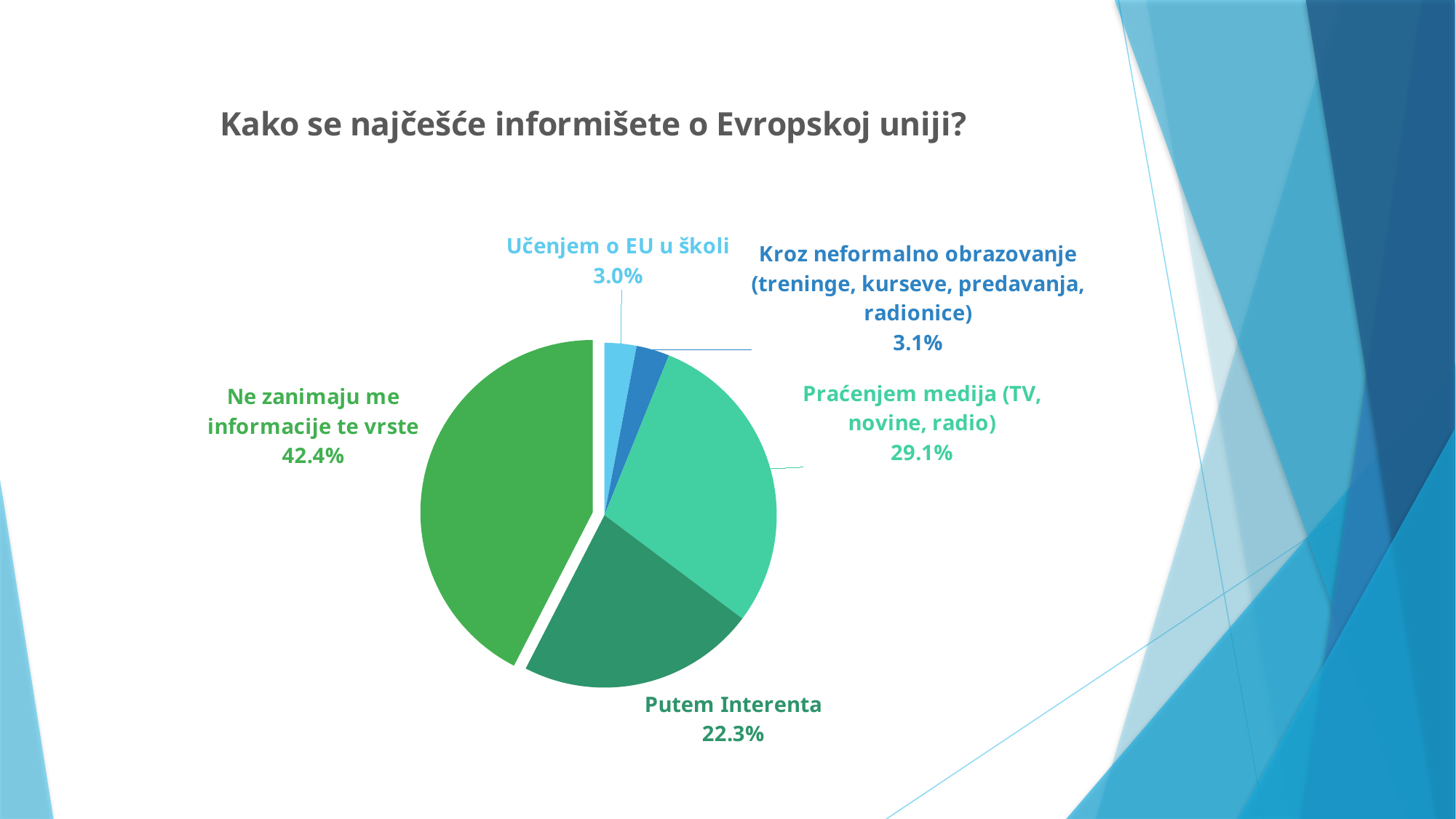
What kind of chart is shown on the slide? Pie chart What is the value for "Kroz neformalno obrazovanje (treninge, kurseve, predavanja, radionice)"? 3.1% What share of the pie is labelled "Ne zanimaju me informacije te vrste"? 42.4% What is the value for "Učenjem o EU u školi"? 3.0% Which is larger: the share for "Ne zanimaju me informacije te vrste" or for "Praćenjem medija (TV, novine, radio)"? Ne zanimaju me informacije te vrste Which category has the smallest share of the pie? Učenjem o EU u školi What is the difference between the shares for "Praćenjem medija (TV, novine, radio)" and "Putem Interenta"? 6.8% What is the title of the chart? Kako se najčešće informišete o Evropskoj uniji? Which category has the largest share of the pie? Ne zanimaju me informacije te vrste How many slices does the pie chart have? 5 What is the value for "Praćenjem medija (TV, novine, radio)"? 29.1% What is the value for "Putem Interenta"? 22.3%